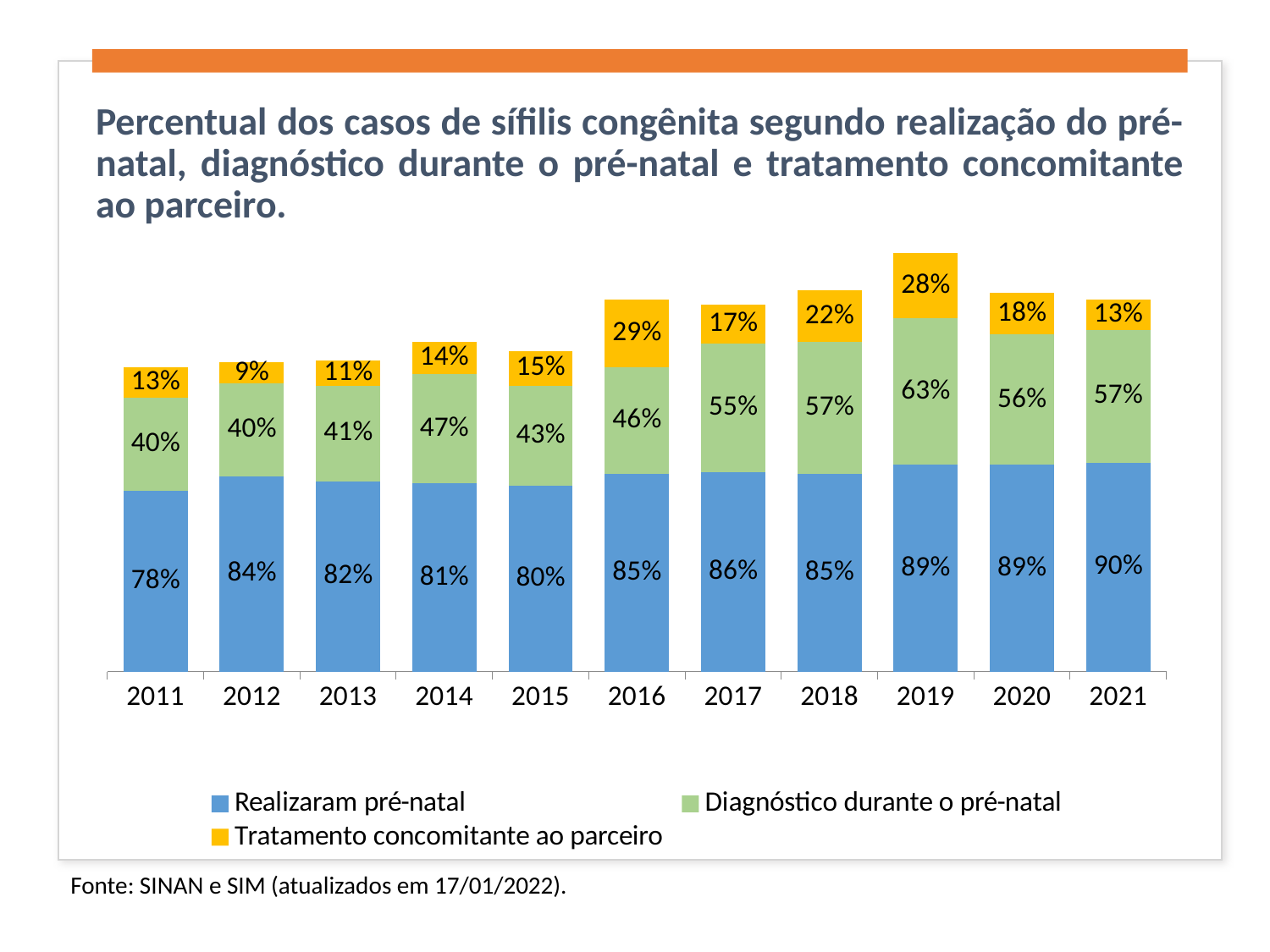
What is the value for 'Realizaram pré-natal' in 2011? 78% What is the value for 'Diagnóstico durante o pré-natal' in 2019? 63% In which year is the value for 'Realizaram pré-natal' highest? 2021 In which year is the value for 'Diagnóstico durante o pré-natal' highest? 2019 What is the value for 'Tratamento concomitante ao parceiro' in 2016? 29% Which colour represents 'Tratamento concomitante ao parceiro' in the chart? Yellow What type of chart is shown on the slide? Stacked bar chart In which year is the value for 'Tratamento concomitante ao parceiro' lowest? 2012 Which is larger, the 'Tratamento concomitante ao parceiro' value for 2019 or for 2021? 2019 How many series does the legend list? 3 What is the difference between the 'Realizaram pré-natal' values for 2021 and 2011? 12% How many years are shown on the x axis? 11